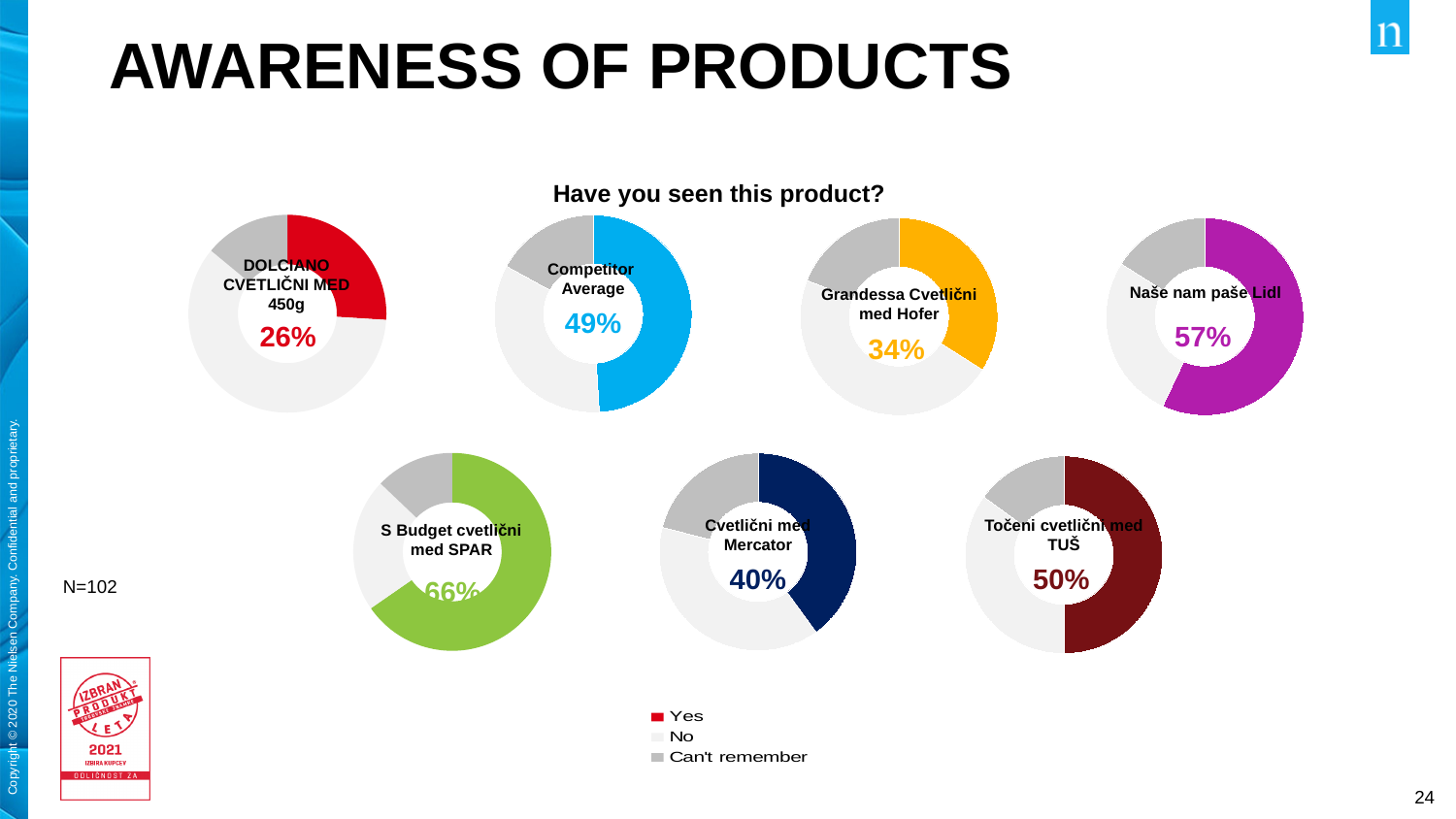
Which has a higher awareness percentage, Naše nam paše Lidl or Cvetlični med Mercator? Naše nam paše Lidl What percentage of respondents have seen DOLCIANO CVETLIČNI MED 450g? 26% How many entries does the legend list? 3 What is the Competitor Average percentage shown on the slide? 49% Which product has the highest awareness percentage? S Budget cvetlični med SPAR What percentage is shown for S Budget cvetlični med SPAR? 66% What is the 'Yes' share shown for Naše nam paše Lidl? 57% How many donut charts are shown on the slide? 7 What is the difference between the awareness of Točeni cvetlični med TUŠ and Grandessa Cvetlični med Hofer? 16% What type of chart is used to show the awareness of each product? Pie (donut) chart What percentage is shown for Cvetlični med Mercator? 40% Which product has the lowest awareness percentage? DOLCIANO CVETLIČNI MED 450g